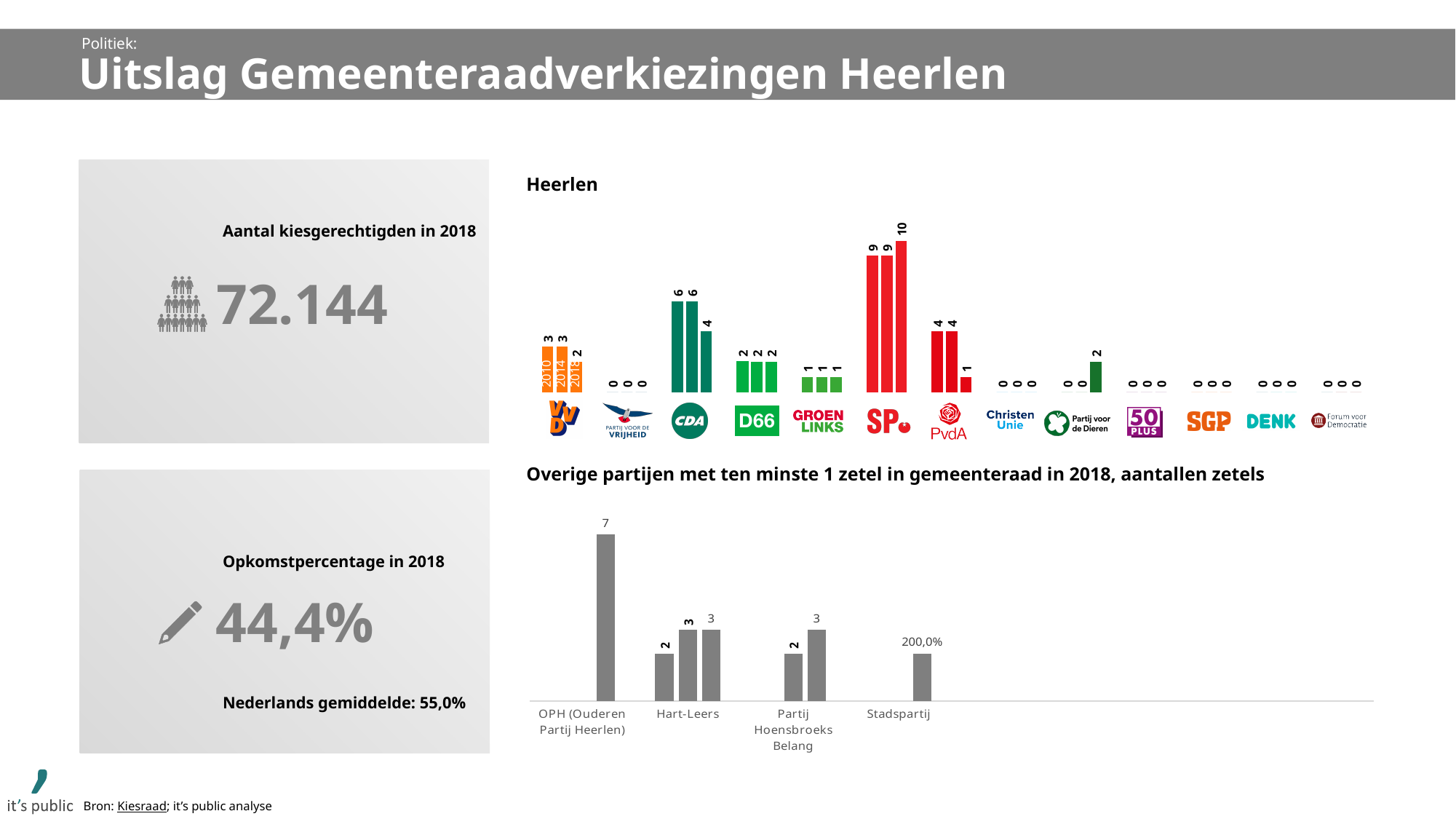
In the Heerlen chart, how many seats did PvdA have in 2018? 1 In the chart 'Overige partijen met ten minste 1 zetel in gemeenteraad in 2018, aantallen zetels', which party has the most seats? OPH (Ouderen Partij Heerlen) In the Heerlen chart, which party had the most seats in 2018? SP In the Heerlen chart, how many seats did CDA have in 2018? 4 What kind of chart is the 'Overige partijen met ten minste 1 zetel in gemeenteraad in 2018' chart? Bar chart In the Heerlen chart, what is the difference between SP's seats in 2018 and CDA's seats in 2018? 6 In the chart 'Overige partijen met ten minste 1 zetel in gemeenteraad in 2018, aantallen zetels', how many seats does OPH (Ouderen Partij Heerlen) have? 7 In the Heerlen chart, which had more seats in 2018: VVD or D66? They are equal (2 each) In the Heerlen chart, which three years are shown for each party? 2010, 2014, 2018 In the Heerlen chart, how many seats did Partij voor de Dieren have in 2018? 2 In the Heerlen chart, how many seats did PvdA have in 2014? 4 In the Heerlen chart, how many seats did SP have in 2018? 10